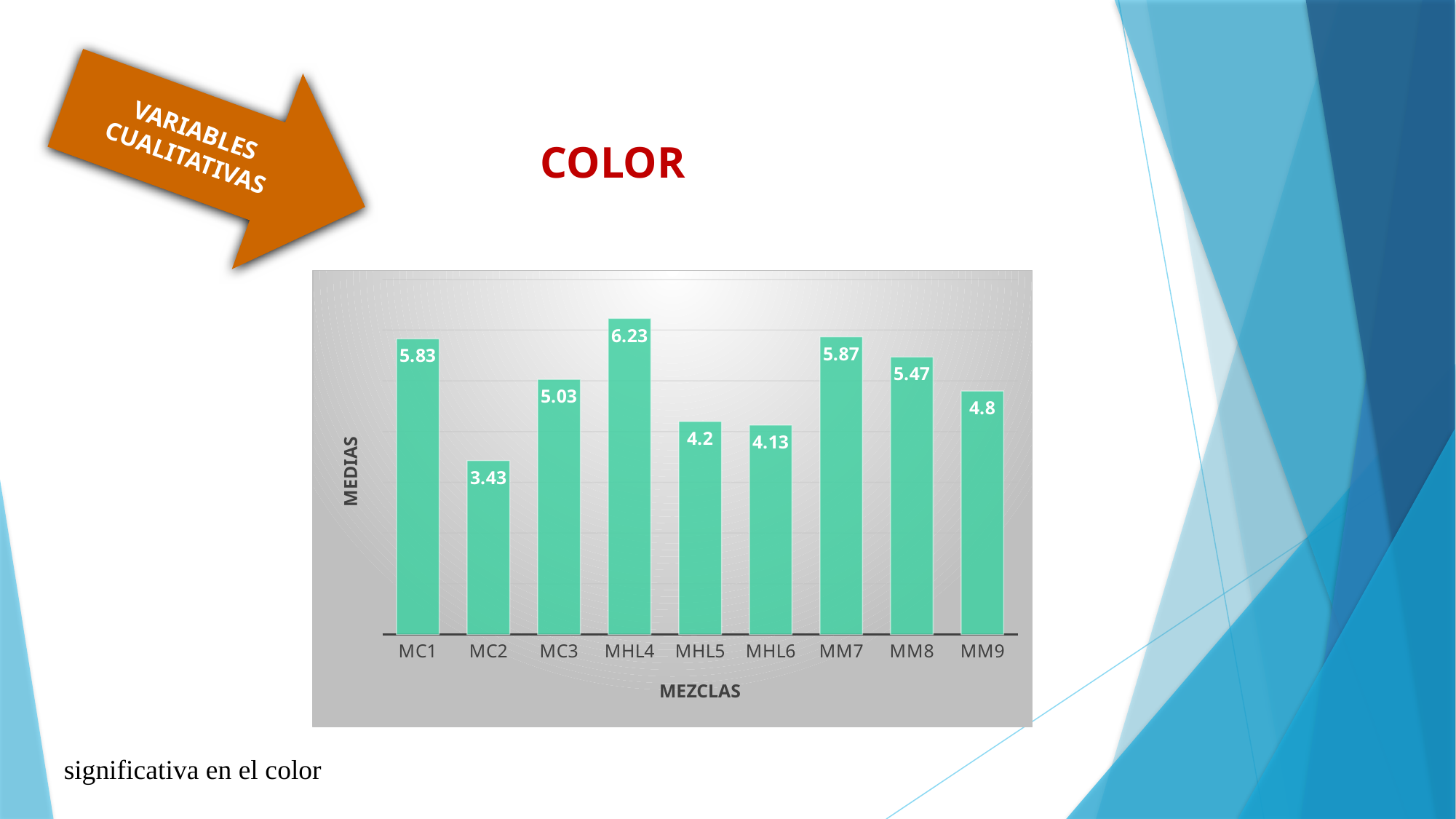
How many categories are shown on the x axis? 9 What kind of chart is shown on the slide? Bar chart What is the difference between the values for MC1 and MC3? 0.8 What is the value for MHL6? 4.13 What is the title of the vertical axis? MEDIAS What is the value for MC2? 3.43 What is the value for MM8? 5.47 What is the value for MHL4? 6.23 What is the difference between the values for MHL4 and MC2? 2.8 Which category has the lowest value? MC2 Which category has the highest value? MHL4 Which is larger, the value for MM8 or the value for MM9? MM8